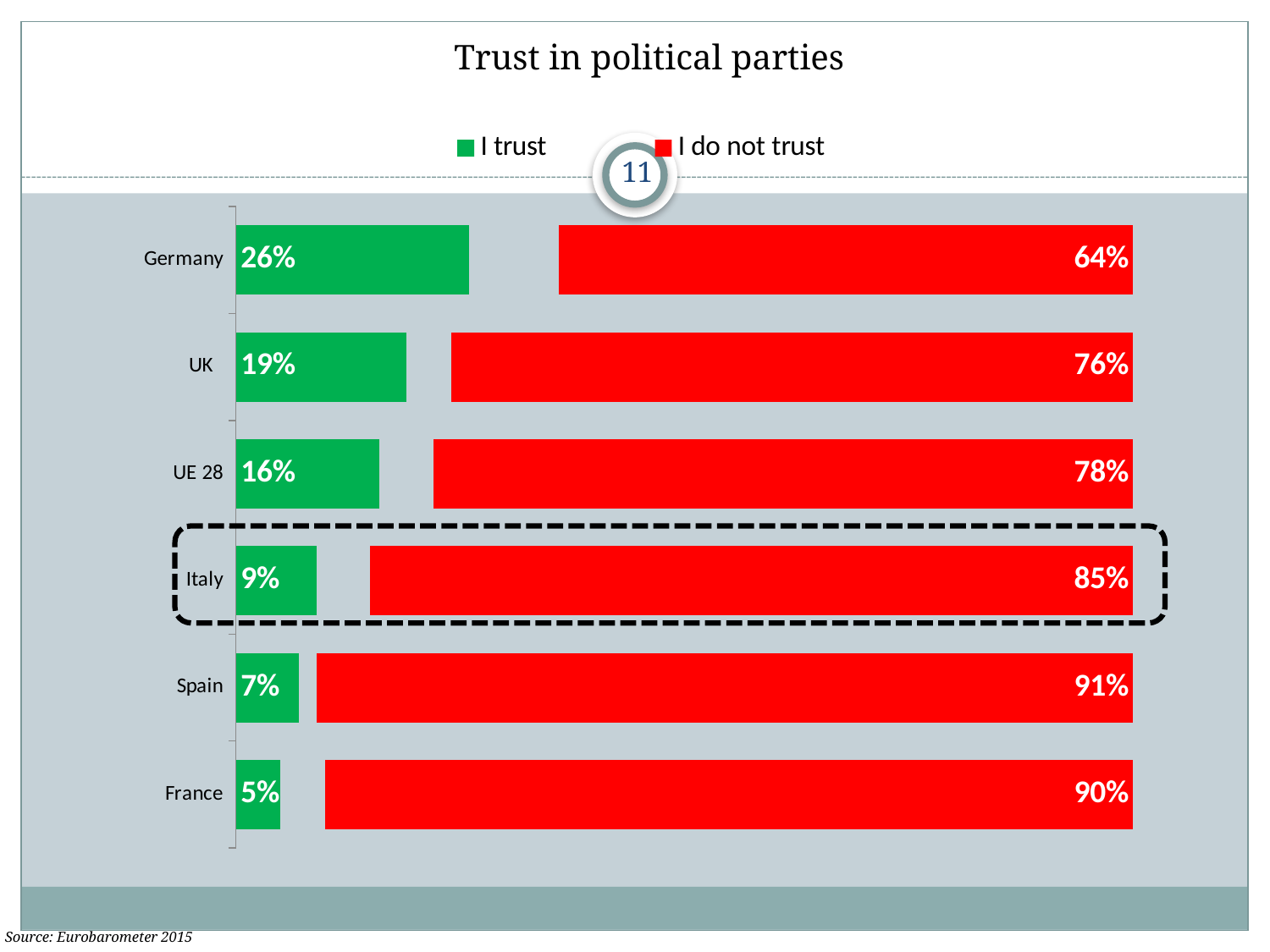
What is the title of the chart? Trust in political parties Which colour represents the 'I do not trust' series? Red What is the 'I do not trust' value for Italy? 85% What is the 'I trust' value for France? 5% Which country has the highest 'I do not trust' value? Spain What percentage of respondents in Germany say they trust political parties? 26% What is the difference between the 'I do not trust' and 'I trust' values for the UK? 57% Which category has the lowest 'I trust' value? France Which is larger, the 'I do not trust' value for Spain or for France? Spain What kind of chart is shown on the slide? Bar chart How many countries or categories are shown on the chart? 6 How many series does the legend list? 2